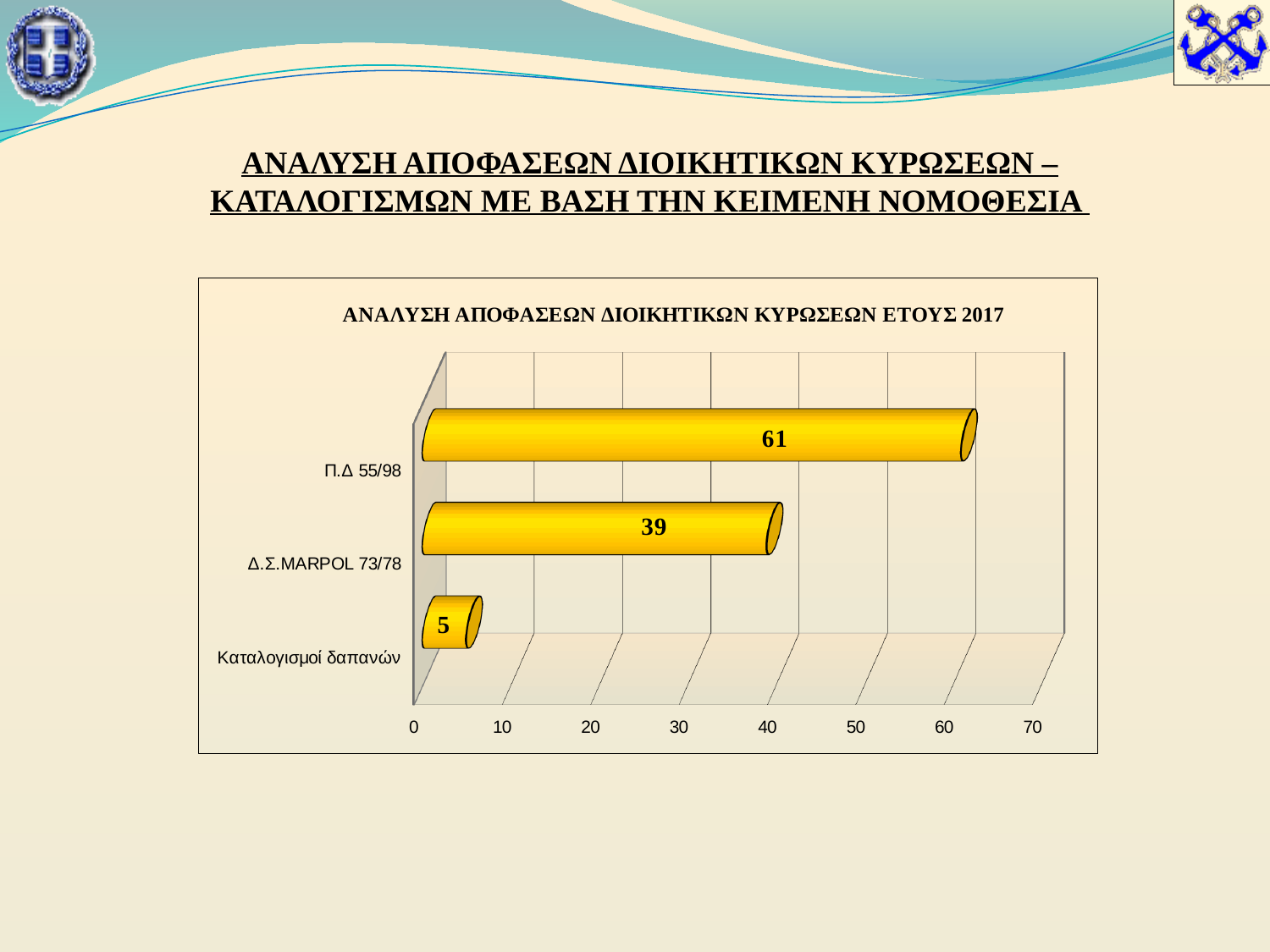
What is the difference between the values for Δ.Σ.MARPOL 73/78 and Καταλογισμοί δαπανών? 34 Which category has the lowest value? Καταλογισμοί δαπανών What is the title of the chart? ΑΝΑΛΥΣΗ ΑΠΟΦΑΣΕΩΝ ΔΙΟΙΚΗΤΙΚΩΝ ΚΥΡΩΣΕΩΝ ΕΤΟΥΣ 2017 Is the value for Π.Δ 55/98 greater or less than 50? greater Which category has the highest value? Π.Δ 55/98 What is the value for Καταλογισμοί δαπανών? 5 How many categories are shown in the chart? 3 What is the difference between the values for Π.Δ 55/98 and Δ.Σ.MARPOL 73/78? 22 What is the value for Π.Δ 55/98? 61 Which is larger, the value for Δ.Σ.MARPOL 73/78 or the value for Καταλογισμοί δαπανών? Δ.Σ.MARPOL 73/78 What kind of chart is shown on the slide? bar chart What is the value for Δ.Σ.MARPOL 73/78? 39